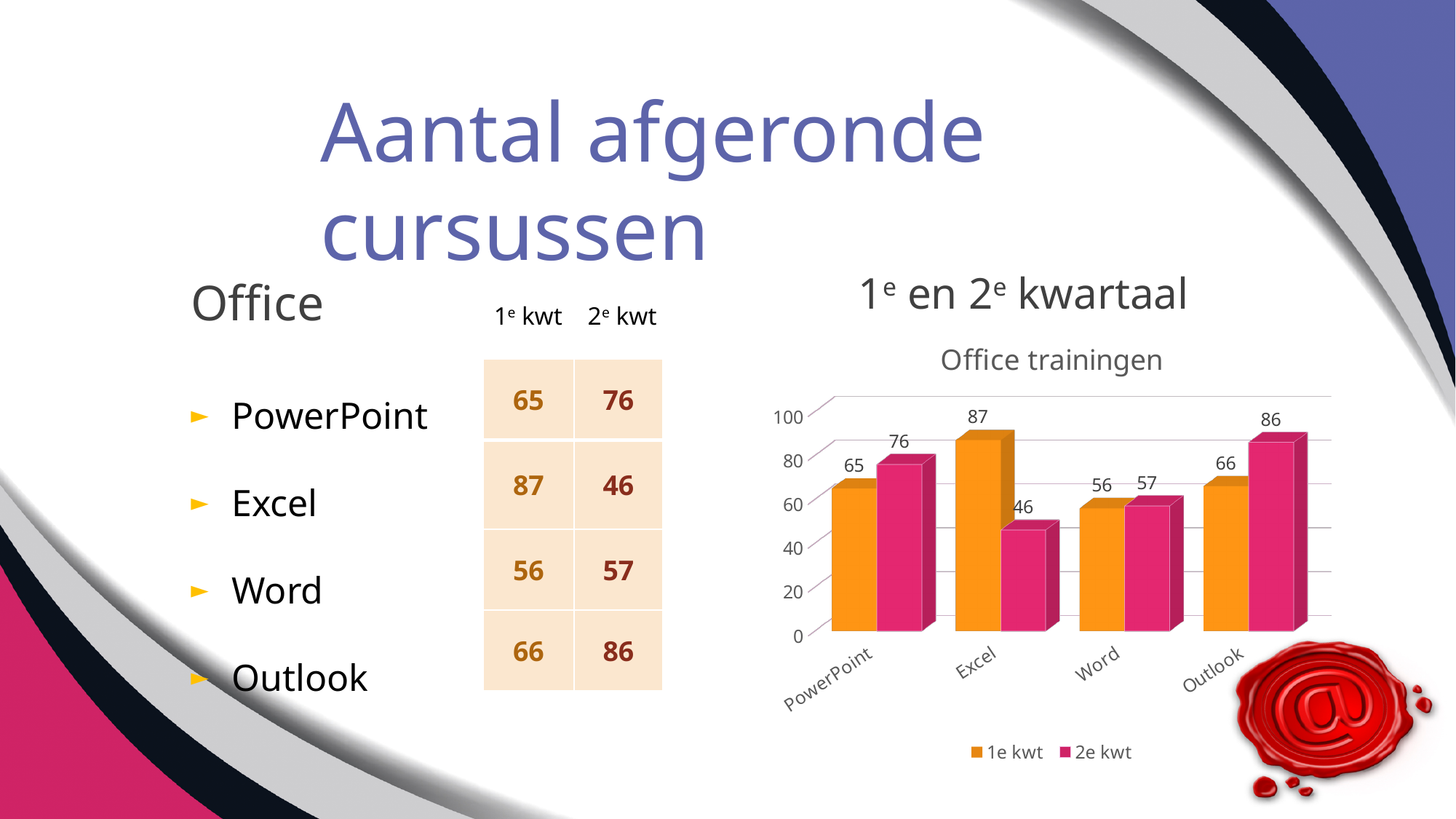
What is the value for Word in the 2e kwt series? 57 Which is larger for Outlook: the 1e kwt value or the 2e kwt value? 2e kwt What is the difference between the 2e kwt and 1e kwt values for PowerPoint? 11 Which category has the highest value in the 1e kwt series? Excel What is the value for Excel in the 1e kwt series? 87 What is the difference between the 1e kwt and 2e kwt values for Excel? 41 How many series does the chart legend list? 2 What is the value for Outlook in the 2e kwt series? 86 What kind of chart is shown on the slide? bar chart Which category has the lowest value in the 2e kwt series? Excel What is the title of the chart? Office trainingen How many categories are shown on the x axis of the chart? 4